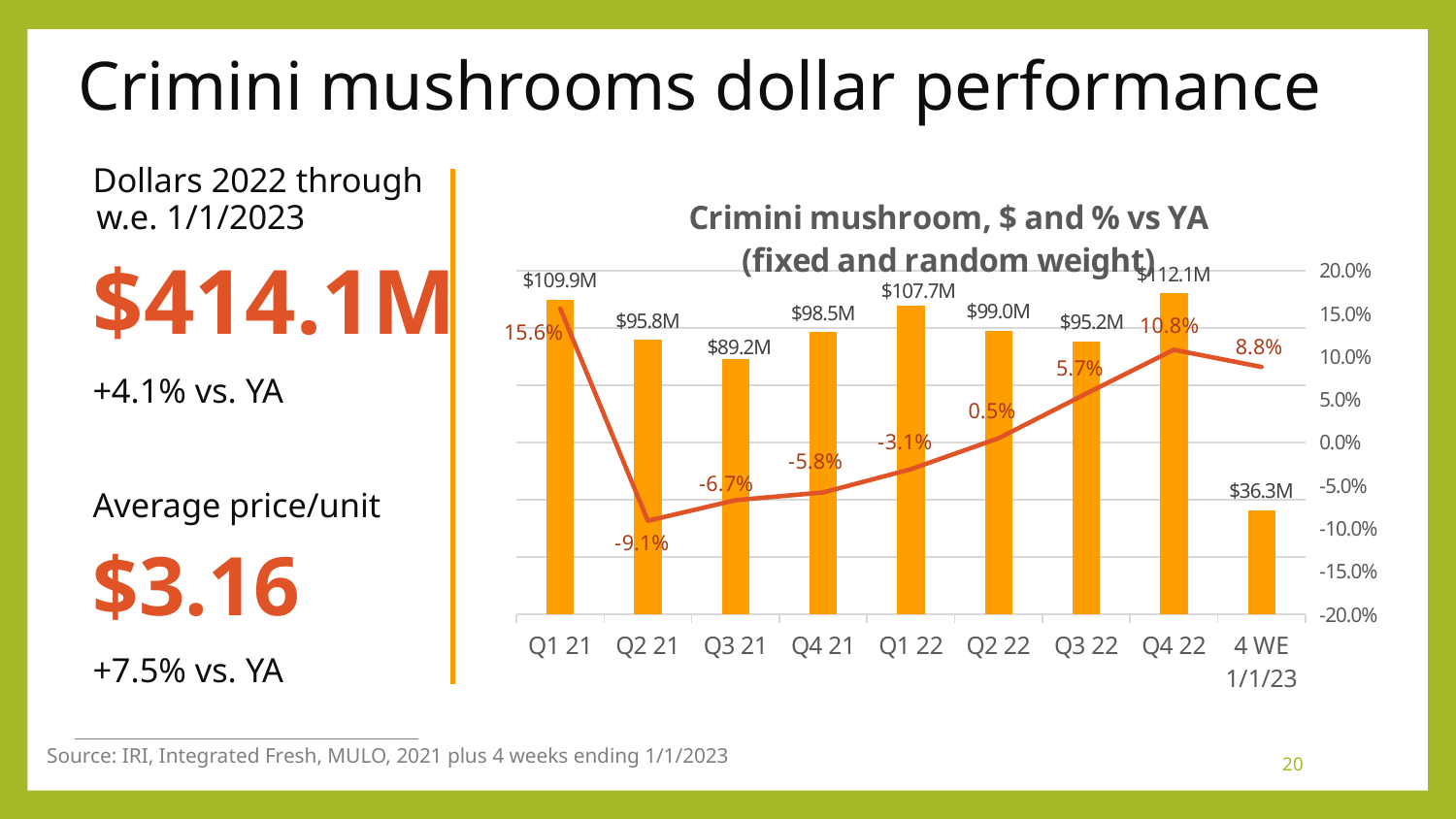
What is the title of the chart? Crimini mushroom, $ and % vs YA (fixed and random weight) How many periods are shown on the x axis? 9 What kind of chart is this? Combined bar and line chart Which period has the highest dollar value? Q4 22 What is the % vs YA value shown for Q2 21? -9.1% What is the dollar value shown for Q1 22? $107.7M Does the % vs YA line rise or fall from Q2 21 to Q4 22? Rise What is the dollar value shown for the 4 WE 1/1/23 period? $36.3M Which has the larger dollar value, Q1 21 or Q1 22? Q1 21 Which period has the lowest % vs YA value? Q2 21 What is the difference in dollars between Q4 22 and Q3 22? $16.9M What is the % vs YA value shown for Q3 22? 5.7%